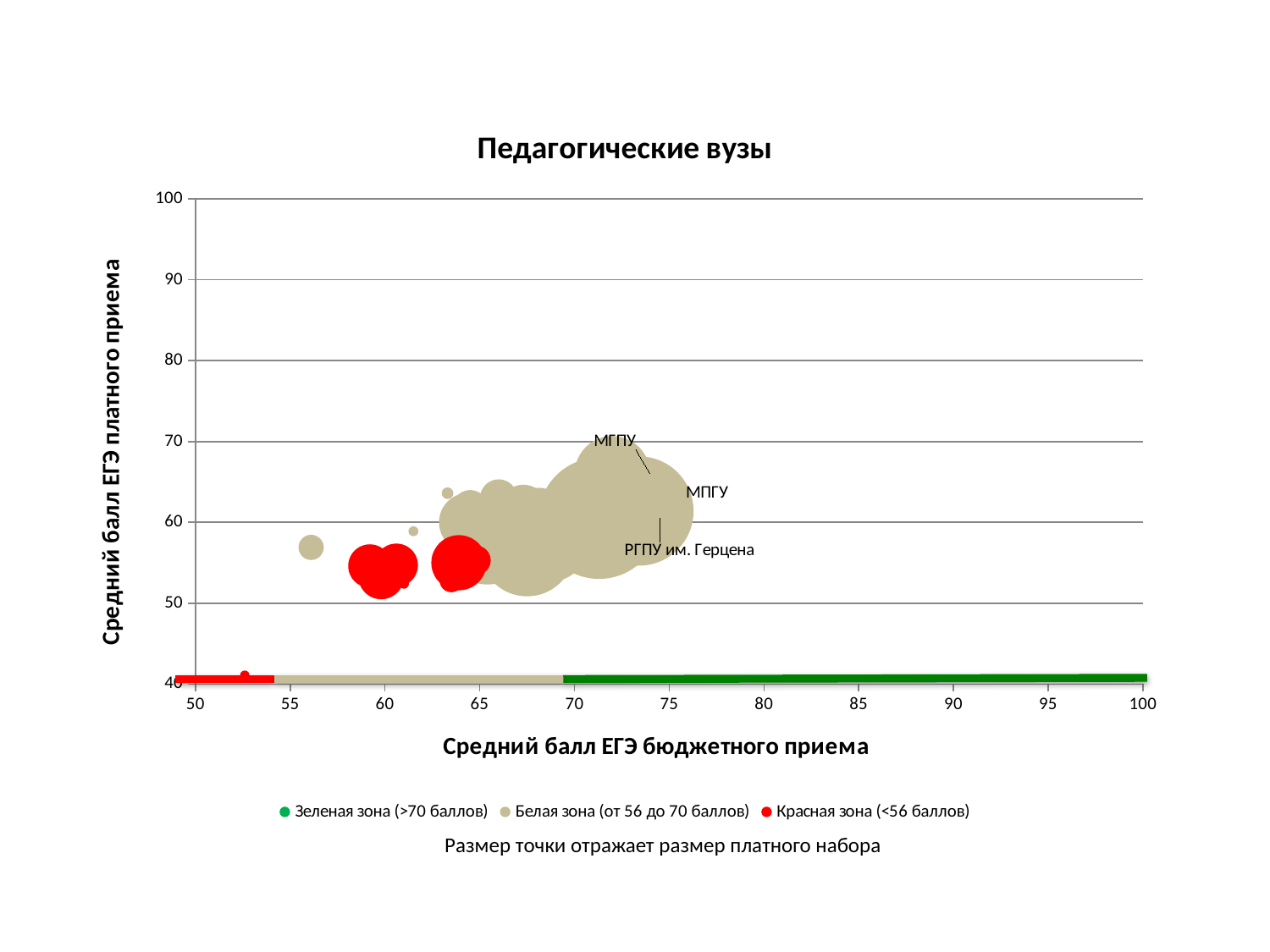
According to the note under the chart, what does the size of a point reflect? Размер платного набора Is the x-axis value for the bubble labelled МПГУ greater or less than 65? greater Which has a larger x-axis value: the bubble labelled МПГУ or the red bubbles? МПГУ What is the title of the chart? Педагогические вузы How many series does the legend list? 3 Is the x-axis value (Средний балл ЕГЭ бюджетного приема) for the red bubbles greater or less than 70? less Is the y-axis value for the bubble labelled МГПУ greater or less than 80? less How many universities are labelled by name on the chart? 3 What kind of chart is shown on the slide? bubble chart